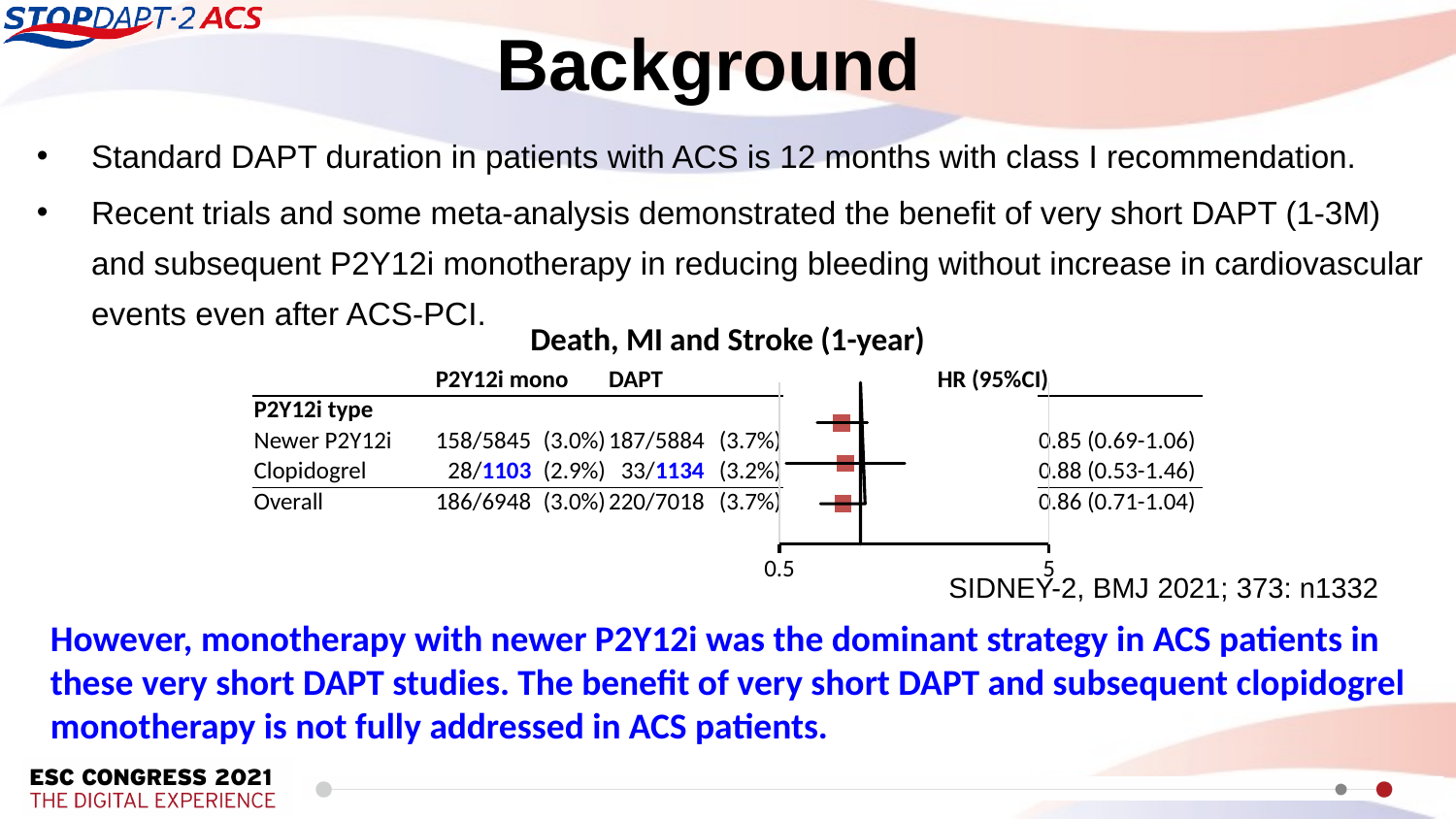
Which P2Y12i type row has the higher hazard ratio point estimate, Newer P2Y12i or Clopidogrel? Clopidogrel Is the Overall hazard ratio greater or less than 0.5? greater How many rows with hazard ratios are plotted in the forest plot? 3 What is the HR (95%CI) for Newer P2Y12i in the forest plot? 0.85 (0.69-1.06) What is the event rate for DAPT in the Overall row? 220/7018 (3.7%) What is the HR (95%CI) for Clopidogrel in the forest plot? 0.88 (0.53-1.46) What is the title of the forest plot on the slide? Death, MI and Stroke (1-year) What kind of chart is shown on the slide? Forest plot What is the event rate for P2Y12i mono in the Clopidogrel row? 28/1103 (2.9%) What is the Overall HR (95%CI) in the forest plot? 0.86 (0.71-1.04) Which row in the forest plot has the lowest hazard ratio point estimate? Newer P2Y12i In the Overall row, what is the difference in event percentage between DAPT and P2Y12i mono? 0.7%